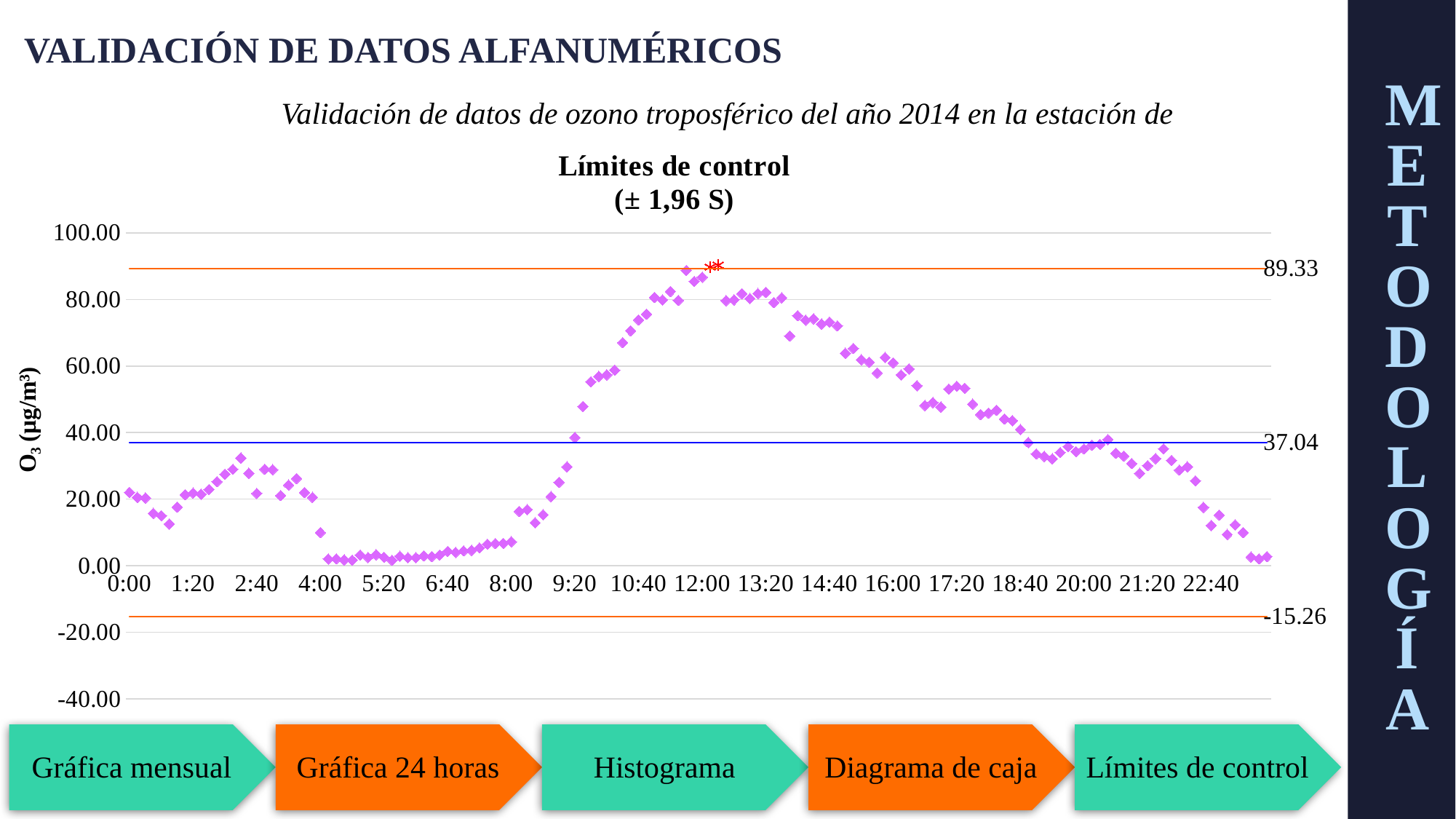
Do the values rise or fall along the x axis between 4:00 and 12:00? rise What is the value printed for the upper control limit line? 89.33 Is the value at 5:20 greater or less than 20? less What is the title of the chart? Límites de control (± 1,96 S) What is the difference between the upper control limit (89.33) and the centre line value (37.04)? 52.29 What kind of chart is shown on the slide? scatter chart Is the value at 0:00 greater or less than 40? less What is the difference between the upper control limit (89.33) and the lower control limit (-15.26)? 104.59 What is the value printed for the blue centre line? 37.04 What is the value printed for the lower control limit line? -15.26 Is the value at 12:00 greater or less than 80? greater How many time labels are shown on the x axis? 18